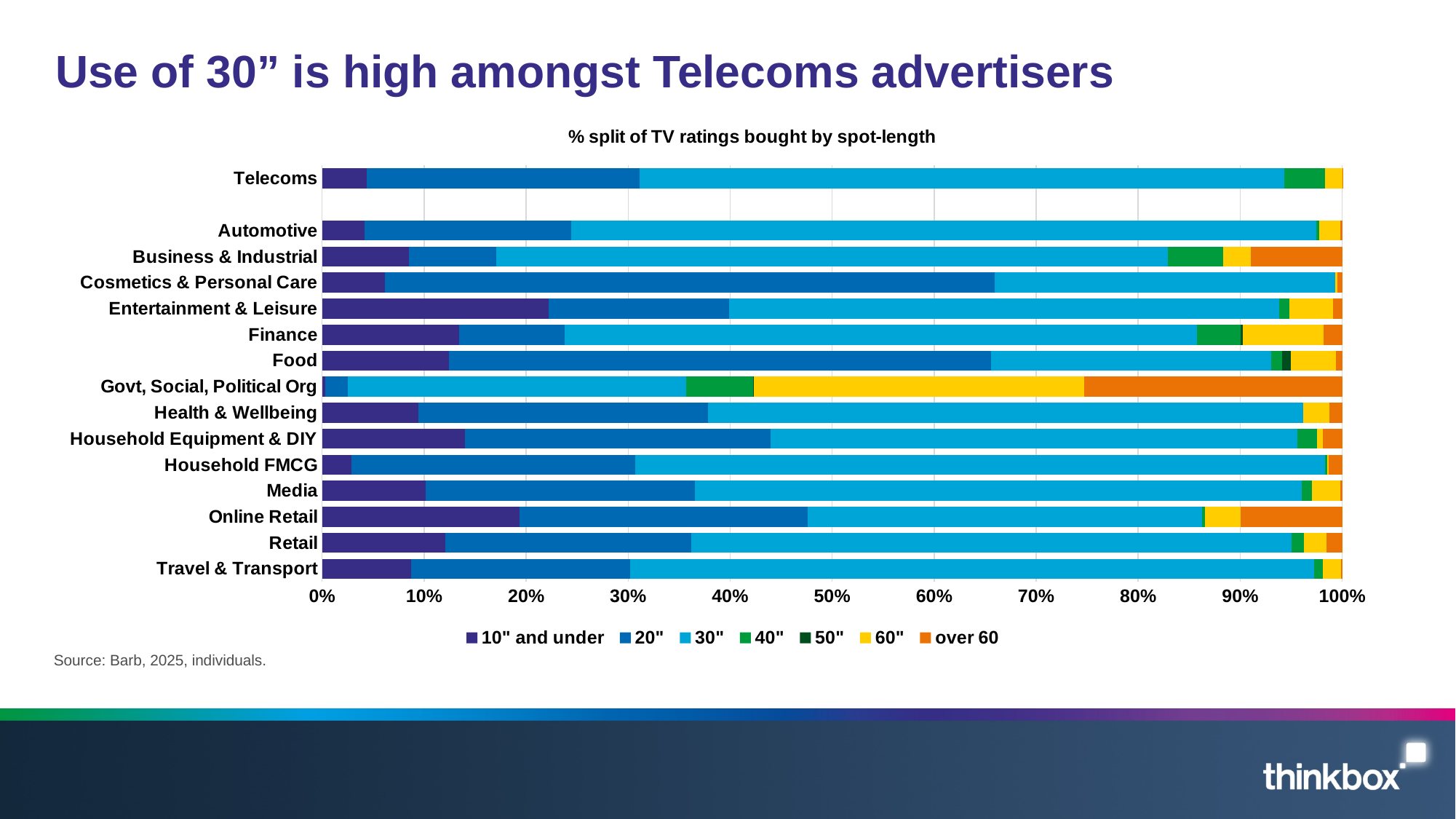
How many advertiser categories are plotted on the chart? 15 Which category has the largest '30"' share? Automotive Which category has the smallest '20"' share? Govt, Social, Political Org What kind of chart is shown on the slide? Stacked bar chart Is the '60"' share for Govt, Social, Political Org greater or less than 20%? greater Which has the larger '20"' share, Cosmetics & Personal Care or Finance? Cosmetics & Personal Care Which category has the largest '10" and under' share? Entertainment & Leisure What does each stacked bar total? 100% Which category has the largest 'over 60' share? Govt, Social, Political Org Is the '20"' share for Telecoms greater or less than 20%? greater What is the title of the chart? % split of TV ratings bought by spot-length How many spot-length series does the legend list? 7